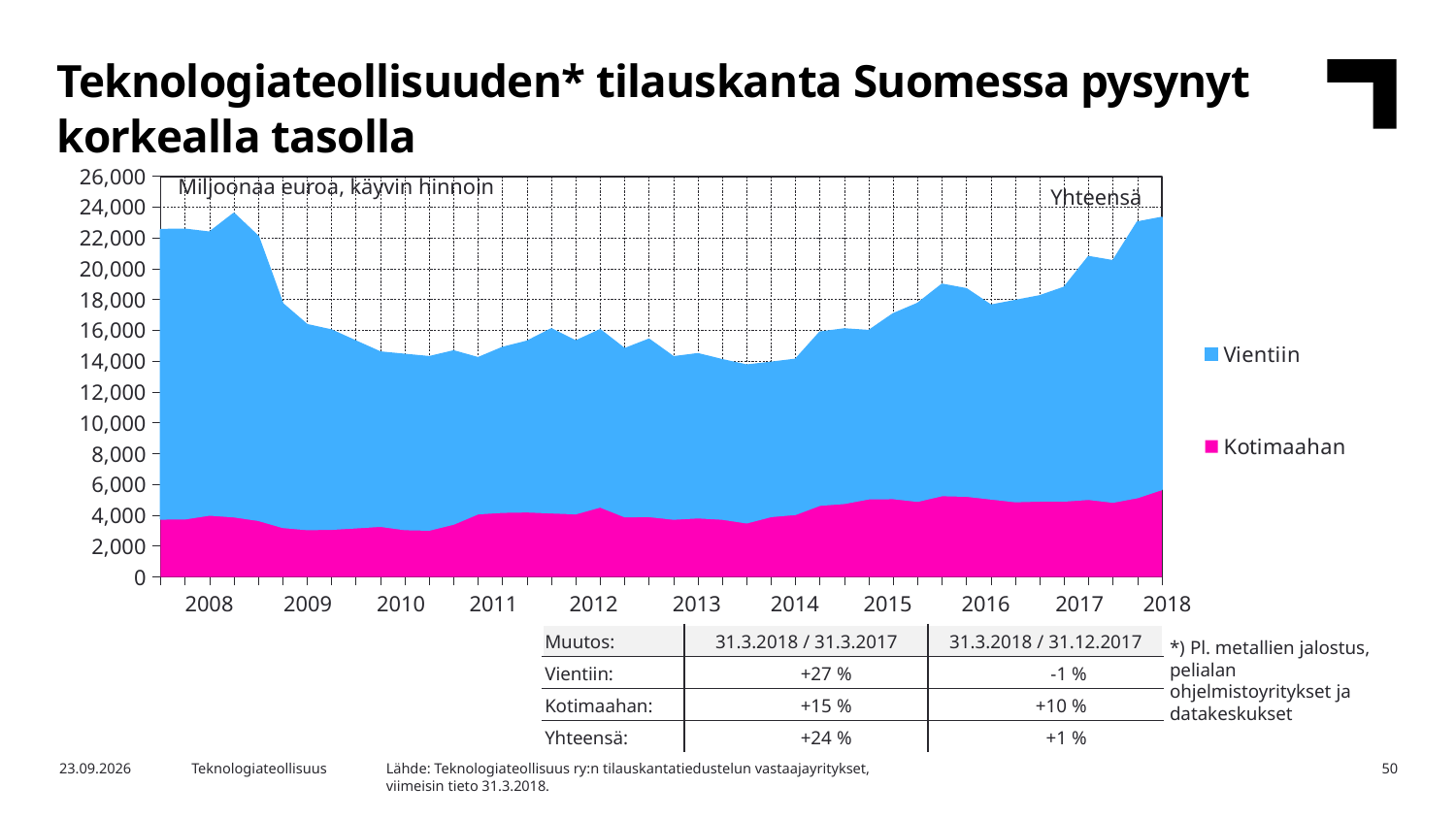
Is the Kotimaahan value at 2010 greater or less than 4,000? less Is the total (Yhteensä) value at 2014 greater or less than 16,000? less What kind of chart is shown on the slide? area chart Is the Kotimaahan value at 2018 greater or less than 4,000? greater Does the total (Yhteensä) value rise or fall between 2008 and 2010? fall Which two series are listed in the chart legend? Vientiin and Kotimaahan Does the total (Yhteensä) value rise or fall between 2014 and 2018? rise How many series does the chart legend list? 2 What unit label is shown inside the chart area? Miljoonaa euroa, käyvin hinnoin Which series is larger at 2018, Vientiin or Kotimaahan? Vientiin